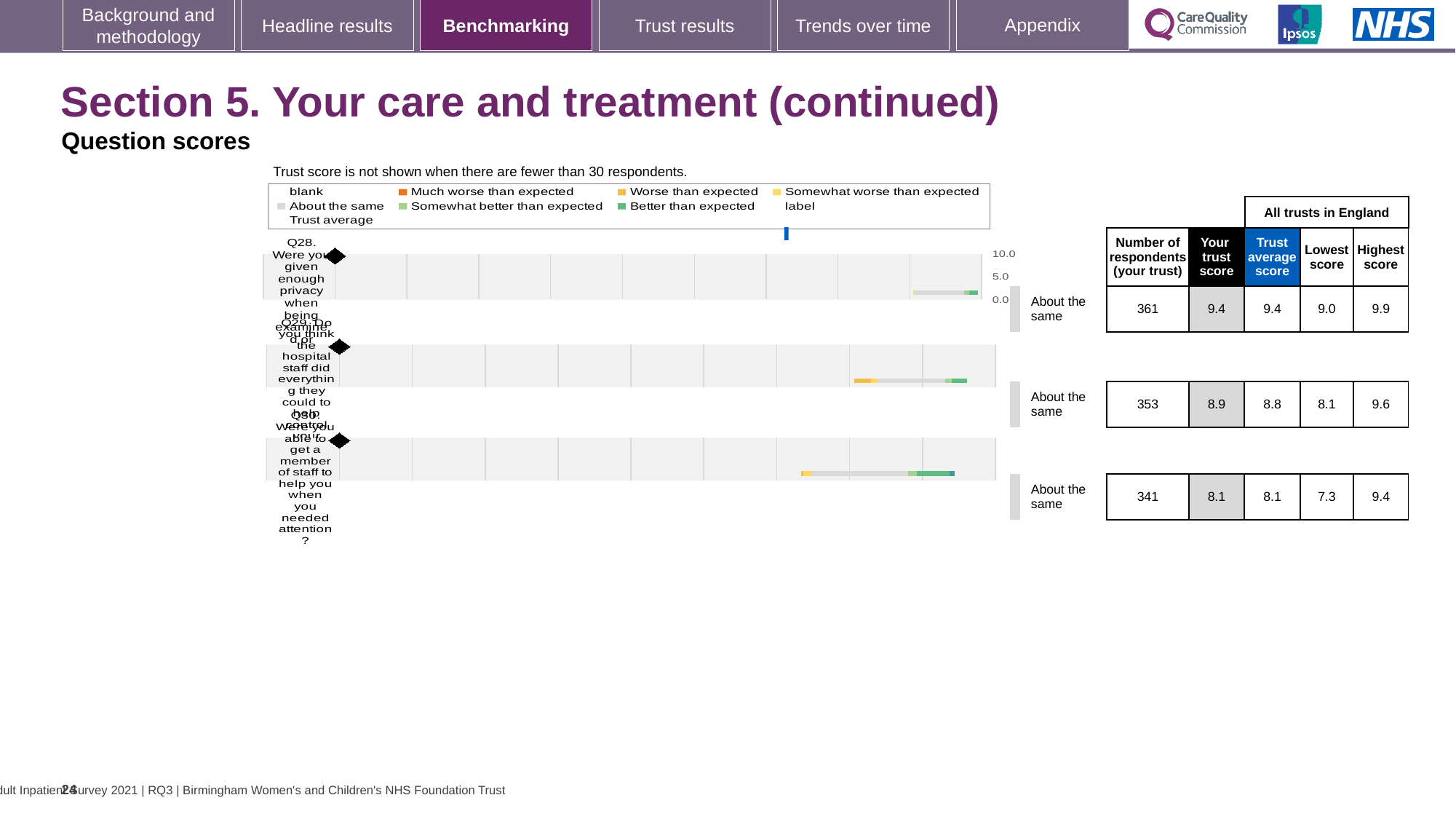
How many questions (categories) are plotted in the question scores chart? 3 What is the difference between the highest score and the lowest score for Q28? 0.9 What is the trust score for Q28 (Were you given enough privacy when being examined or treated)? 9.4 Which question has the lowest trust score? Q30 For Q29, which is larger: the trust score or the trust average score? the trust score What is the highest score across all trusts in England for Q30 (Were you able to get a member of staff to help you when you needed attention)? 9.4 How many respondents answered Q29 (Do you think the hospital staff did everything they could to help control your pain)? 353 What is the lowest score across all trusts in England for Q29? 8.1 Is the trust score for Q28 greater or less than 5.0? greater What kind of chart is used to show the question scores on this slide? bar chart What benchmark category is shown for Q30? About the same Which question has the highest trust score? Q28